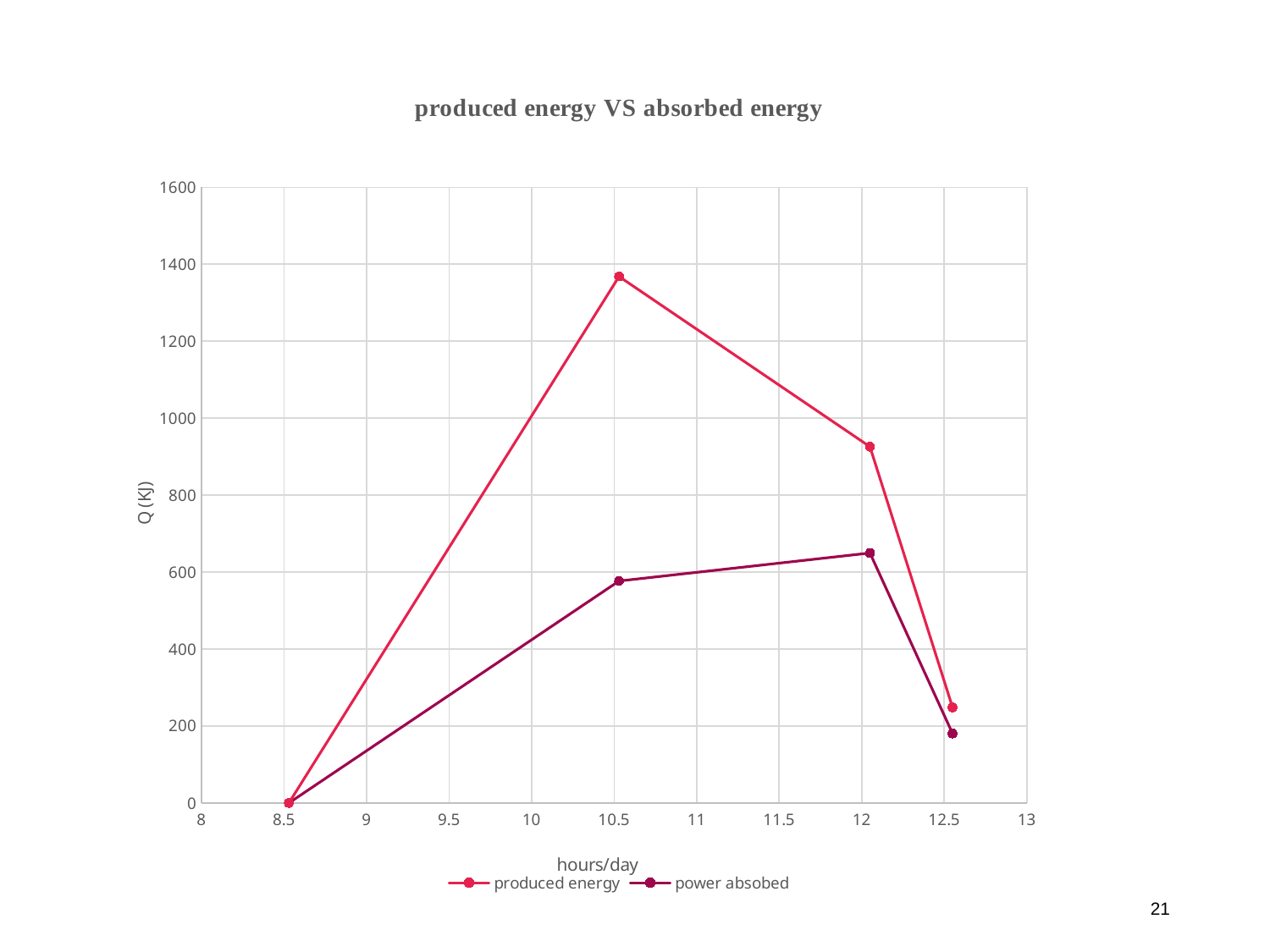
Does the produced energy series rise or fall between 10.5 and 12.5 hours/day? fall How many series does the legend list? 2 At about 12 hours/day, which series has the larger value, produced energy or power absobed? produced energy Is the produced energy value at about 10.5 hours/day greater or less than 1200? greater What is the title of the chart? produced energy VS absorbed energy How many data points are plotted for the produced energy series? 4 What kind of chart is shown on the slide? line chart Is the power absobed value at about 10.5 hours/day greater or less than 400? greater What is the label of the y axis? Q (KJ)